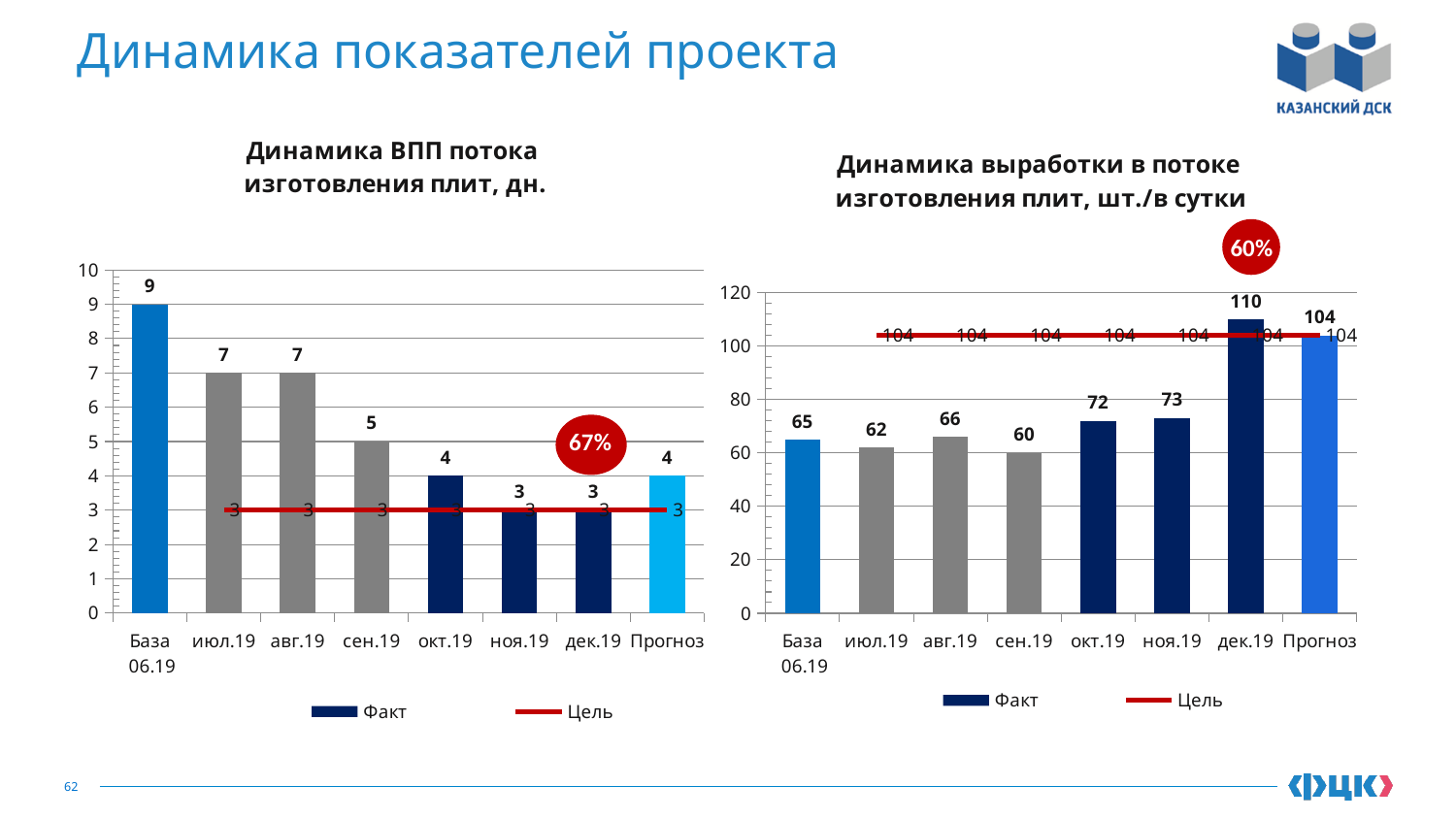
How many series does the legend of the chart 'Динамика ВПП потока изготовления плит, дн.' list? 2 How many categories are shown on the x axis of the chart 'Динамика выработки в потоке изготовления плит, шт./в сутки'? 8 On the chart 'Динамика выработки в потоке изготовления плит, шт./в сутки', what is the difference between the Факт values for дек.19 and База 06.19? 45 On the chart 'Динамика ВПП потока изготовления плит, дн.', what is the difference between the Факт values for База 06.19 and дек.19? 6 On the chart 'Динамика ВПП потока изготовления плит, дн.', what is the Факт value for База 06.19? 9 On the chart 'Динамика выработки в потоке изготовления плит, шт./в сутки', what is the Факт value for дек.19? 110 On the chart 'Динамика выработки в потоке изготовления плит, шт./в сутки', which category has the lowest Факт value? сен.19 On the chart 'Динамика выработки в потоке изготовления плит, шт./в сутки', which is larger, the Факт value for окт.19 or for ноя.19? ноя.19 On the chart 'Динамика ВПП потока изготовления плит, дн.', what is the Цель value shown by the red line? 3 On the chart 'Динамика ВПП потока изготовления плит, дн.', which category has the highest Факт value? База 06.19 On the chart 'Динамика выработки в потоке изготовления плит, шт./в сутки', what is the Факт value for сен.19? 60 On the chart 'Динамика ВПП потока изготовления плит, дн.', what is the Факт value for сен.19? 5